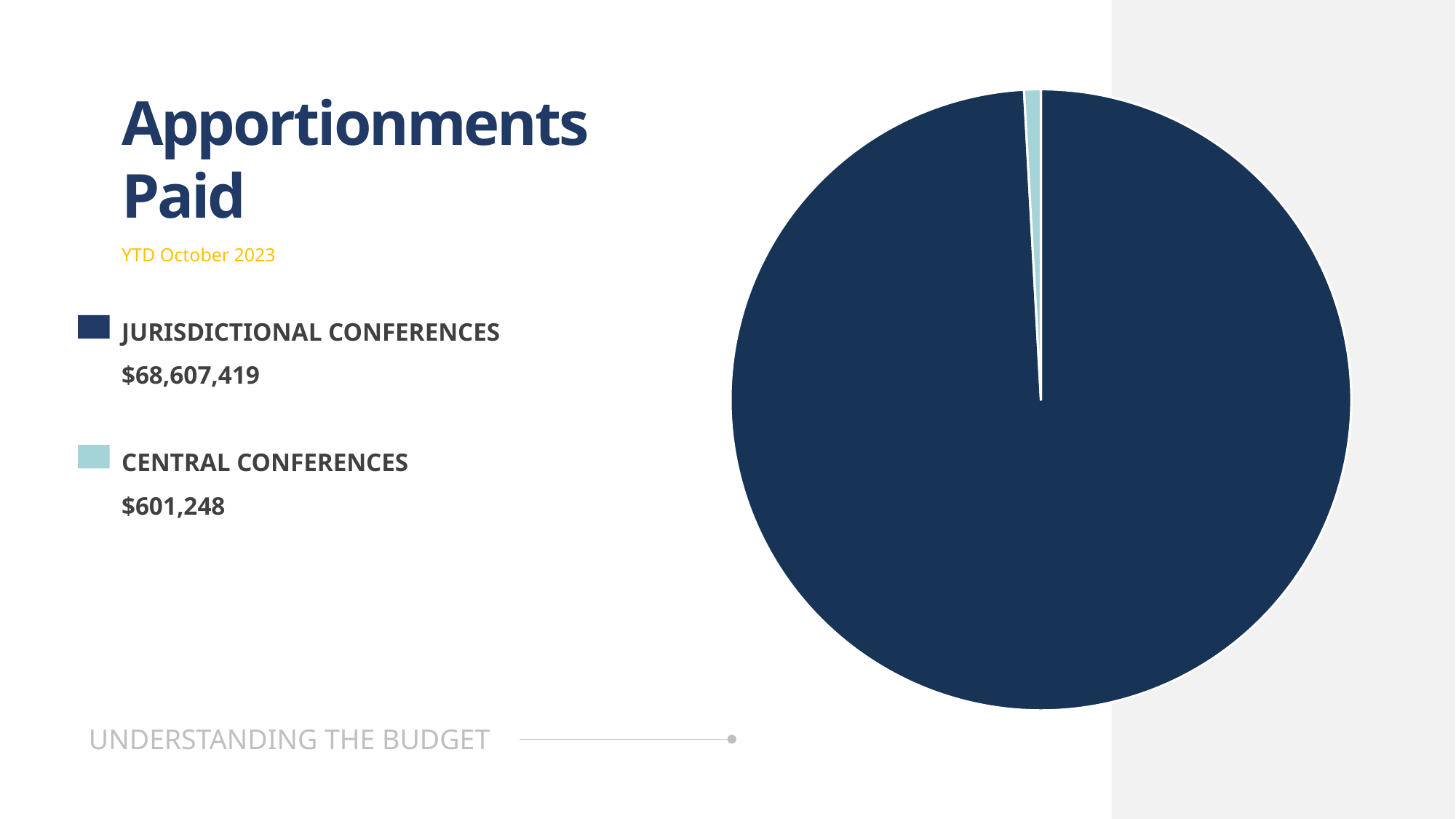
How many entries does the legend list? 2 What kind of chart is shown on the slide? Pie chart What is the value for Central Conferences? $601,248 Which category has the largest slice of the pie? Jurisdictional Conferences What is the value for Jurisdictional Conferences? $68,607,419 How many slices does the pie chart have? 2 What is the total of the two values shown in the pie chart? $69,208,667 What period does the subtitle under the chart title refer to? YTD October 2023 What is the title of the chart? Apportionments Paid What is the difference between the Jurisdictional Conferences value and the Central Conferences value? $68,006,171 Which is larger, the value for Jurisdictional Conferences or the value for Central Conferences? Jurisdictional Conferences Which category has the smallest slice of the pie? Central Conferences